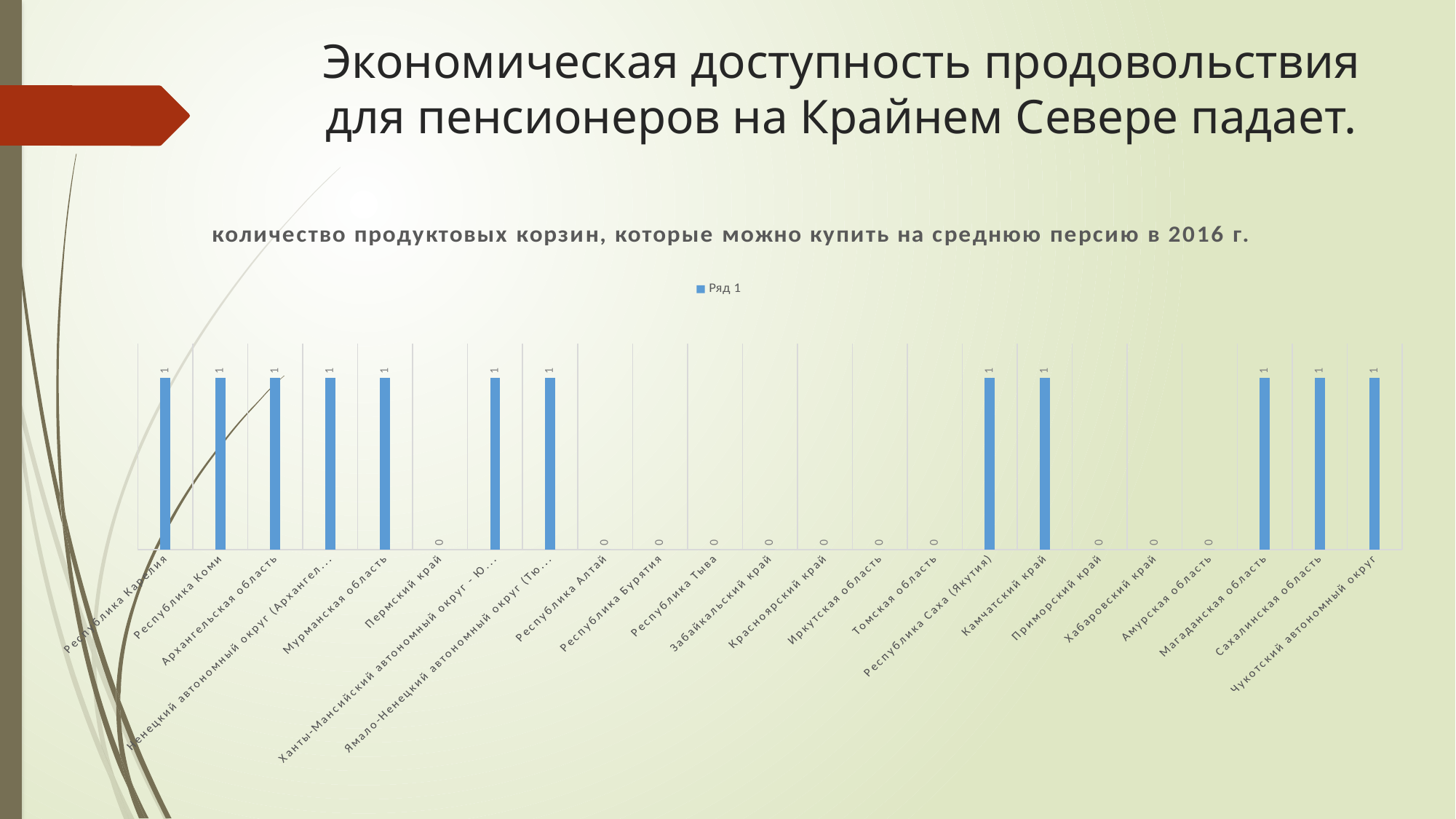
How many series does the legend list? 1 What is the value for Чукотский автономный округ? 1 How many categories have a value of 0? 11 How many categories are shown on the x axis of the chart? 23 What is the difference between the value for Сахалинская область and the value for Амурская область? 1 What is the value for Республика Саха (Якутия)? 1 Which is larger, the value for Камчатский край or the value for Приморский край? Камчатский край What is the value for Красноярский край? 0 What type of chart is shown on the slide? bar chart What is the value for Пермский край? 0 What is the name of the series shown in the legend? Ряд 1 What is the value for Мурманская область? 1